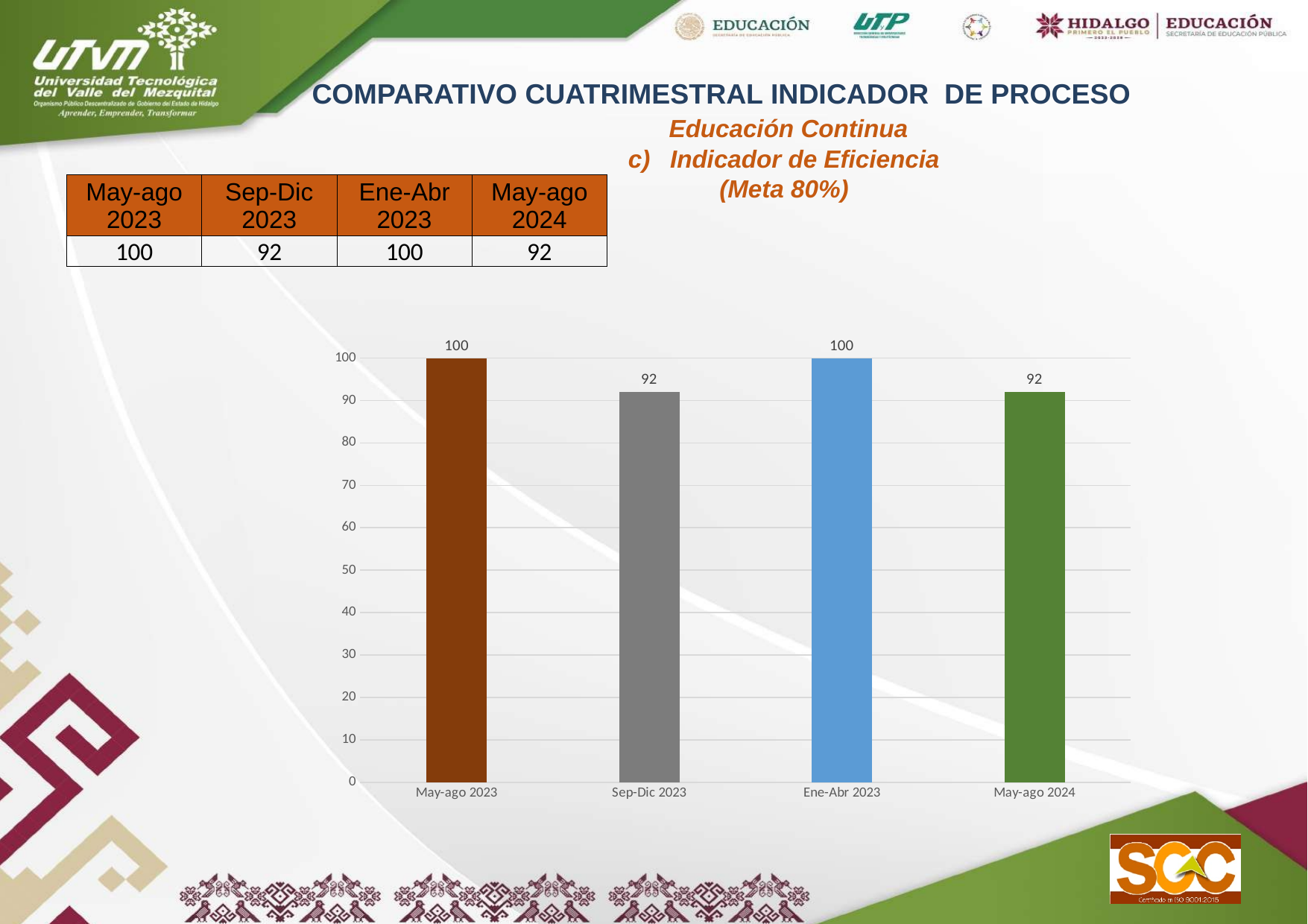
What is the value for May-ago 2023? 100 What colour is the bar for Ene-Abr 2023? blue What is the difference between the values for May-ago 2023 and Sep-Dic 2023? 8 Which is larger, the value for Ene-Abr 2023 or the value for May-ago 2024? Ene-Abr 2023 What kind of chart is shown on the slide? bar chart What is the value for Ene-Abr 2023? 100 What is the value for May-ago 2024? 92 What is the highest value shown on the vertical axis of the chart? 100 What is the value for Sep-Dic 2023? 92 What is the difference between the values for Ene-Abr 2023 and May-ago 2024? 8 Is the value for Sep-Dic 2023 greater or less than 80? greater How many categories are shown on the x axis of the chart? 4